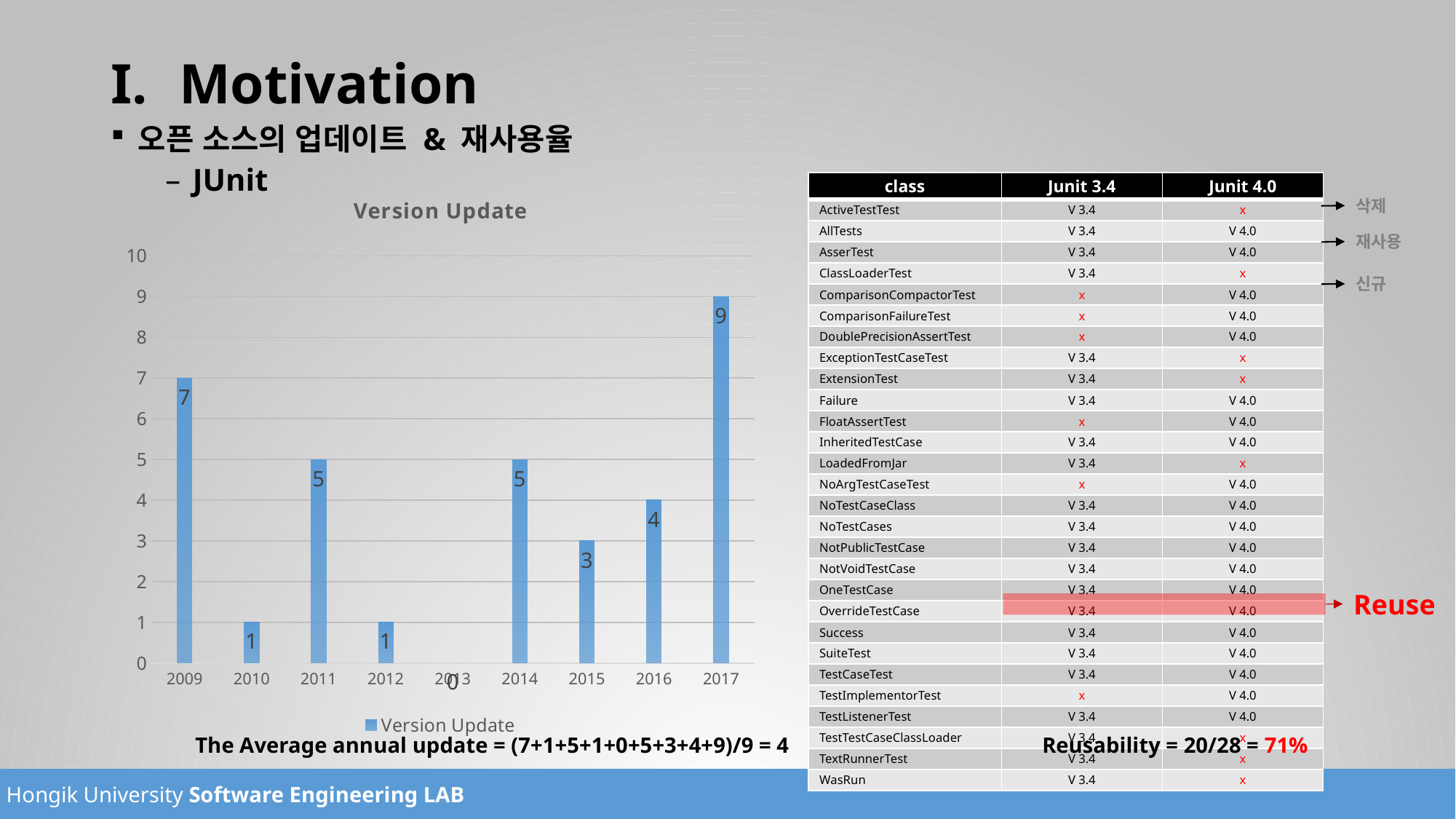
What is the value for 2015 in the Version Update chart? 3 What is the difference between the values for 2017 and 2009 in the Version Update chart? 2 What is the value for 2017 in the Version Update chart? 9 What is the title of the chart on the slide? Version Update Which is larger in the Version Update chart, the value for 2011 or the value for 2016? 2011 Which year has the highest value in the Version Update chart? 2017 What is the value for 2013 in the Version Update chart? 0 How many series does the legend of the Version Update chart list? 1 What kind of chart is the Version Update chart? bar chart What is the value for 2009 in the Version Update chart? 7 Which year has the lowest value in the Version Update chart? 2013 How many years are shown on the x axis of the Version Update chart? 9